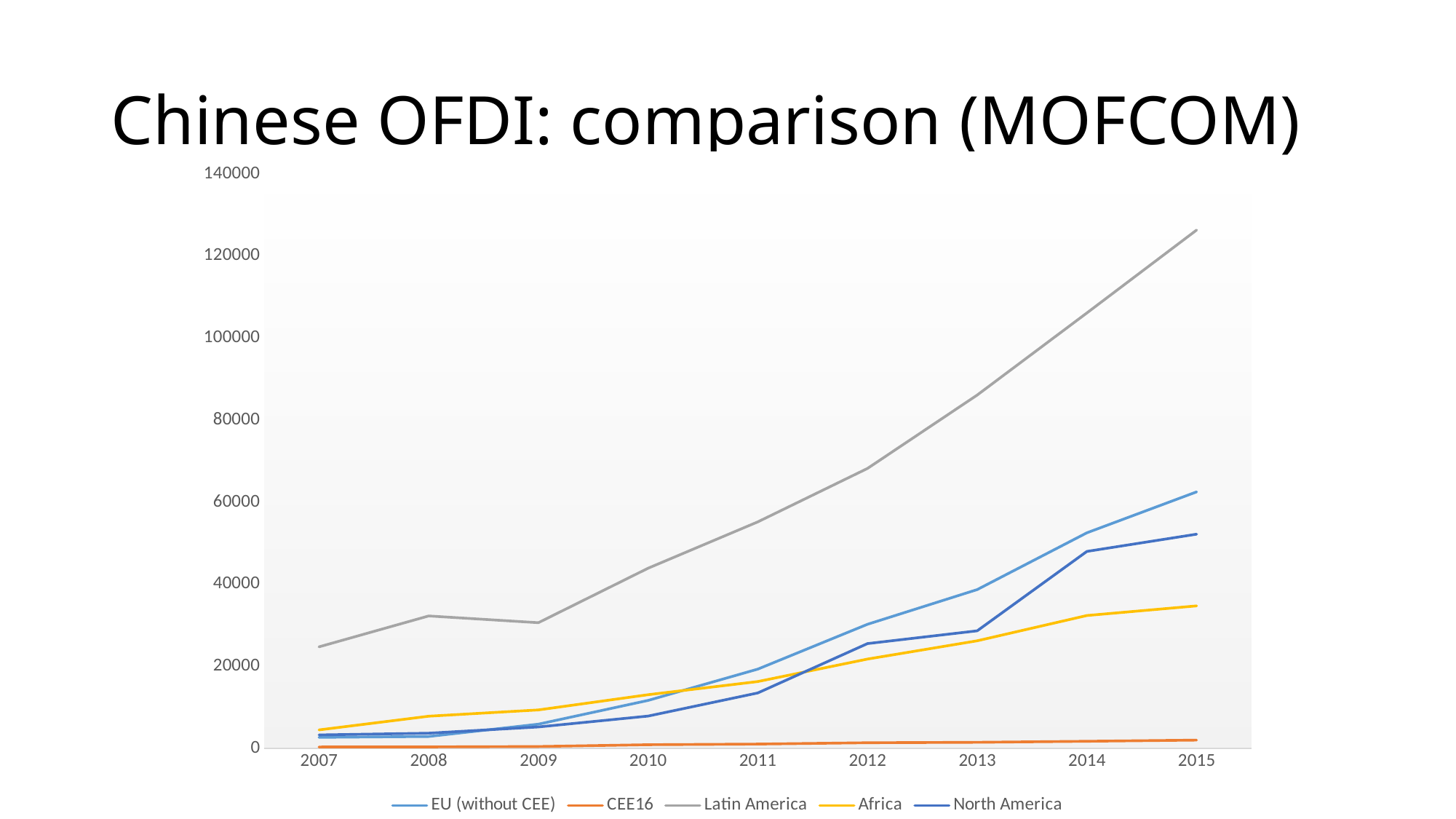
What is the title of the slide? Chinese OFDI: comparison (MOFCOM) Which series has the lowest value in 2015? CEE16 Is the value for Latin America in 2015 greater or less than 120000? greater How many series does the legend list? 5 Is the value for North America in 2015 greater or less than 40000? greater Is the value for Africa in 2015 greater or less than 40000? less What kind of chart is shown on the slide? line chart In 2015, which is larger: EU (without CEE) or North America? EU (without CEE) Does the Latin America line generally rise or fall from 2007 to 2015? rise Which series has the highest value in 2015? Latin America How many years are plotted along the x axis? 9